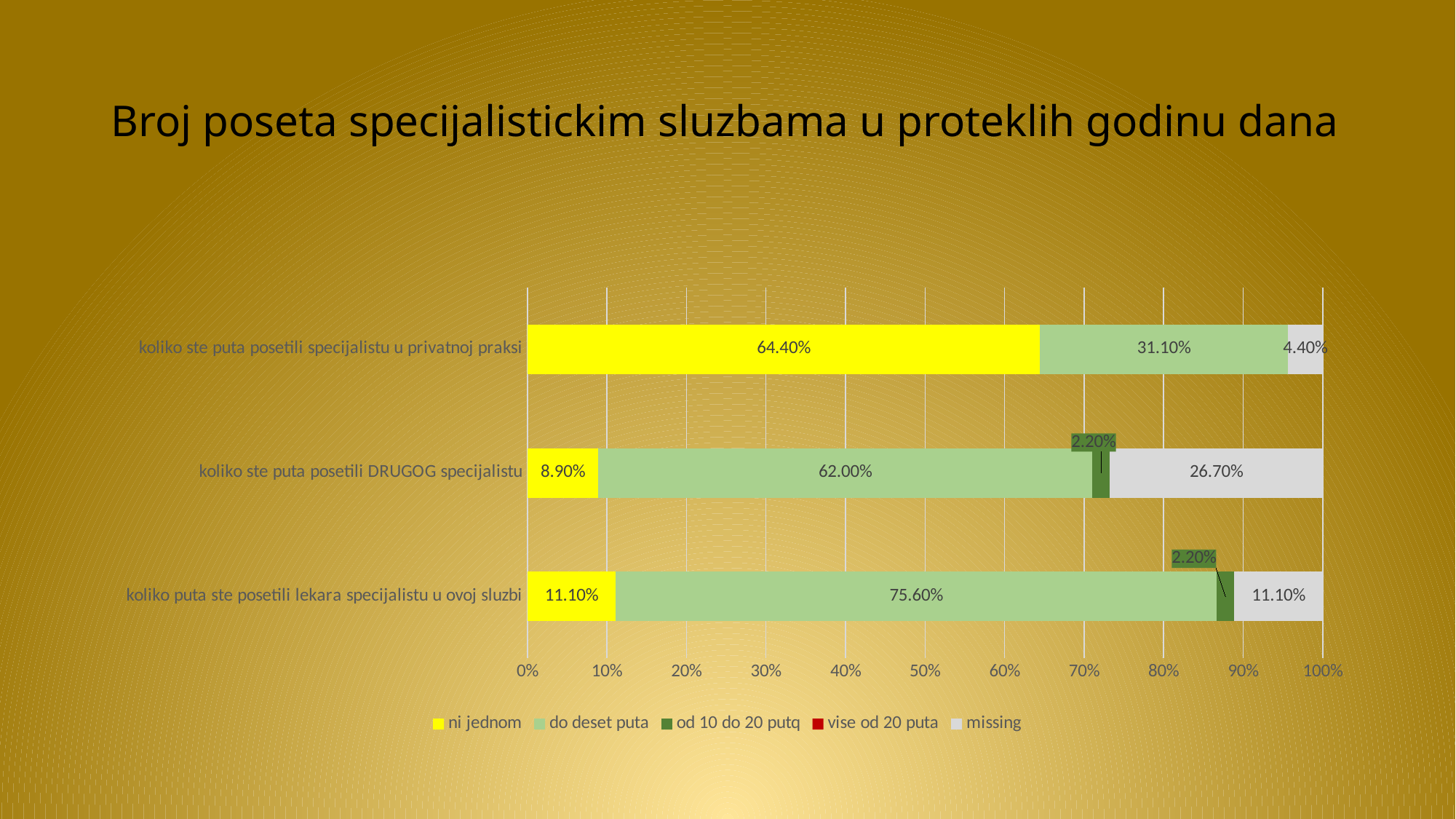
What kind of chart is shown on the slide? stacked bar chart What is the 'od 10 do 20 putq' value for 'koliko ste puta posetili DRUGOG specijalistu'? 2.20% Which is larger: the 'ni jednom' value for 'koliko ste puta posetili DRUGOG specijalistu' or for 'koliko puta ste posetili lekara specijalistu u ovoj sluzbi'? koliko puta ste posetili lekara specijalistu u ovoj sluzbi What is the title of the chart on the slide? Broj poseta specijalistickim sluzbama u proteklih godinu dana Which category has the lowest 'missing' value? koliko ste puta posetili specijalistu u privatnoj praksi Which category has the highest 'ni jednom' value? koliko ste puta posetili specijalistu u privatnoj praksi What is the 'ni jednom' value for 'koliko ste puta posetili specijalistu u privatnoj praksi'? 64.40% How many series does the legend list? 5 What is the 'do deset puta' value for 'koliko puta ste posetili lekara specijalistu u ovoj sluzbi'? 75.60% What is the 'missing' value for 'koliko ste puta posetili DRUGOG specijalistu'? 26.70% What is the difference between the 'do deset puta' values for 'koliko puta ste posetili lekara specijalistu u ovoj sluzbi' and 'koliko ste puta posetili DRUGOG specijalistu'? 13.60% How many categories (bars) are shown in the chart? 3